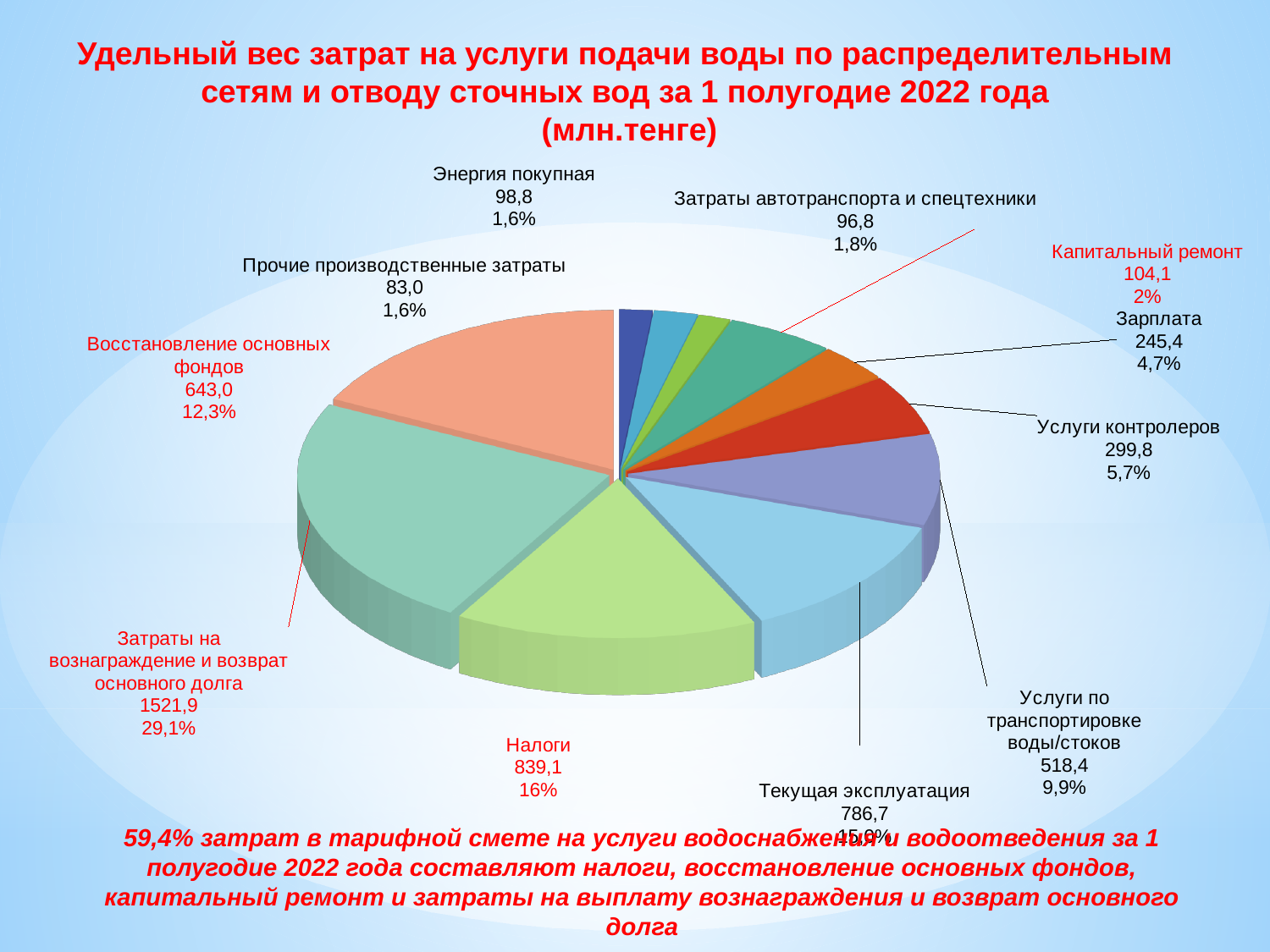
What is the value for Услуги контролеров? 299,8 What is the value for Налоги? 839,1 What share of the pie does Услуги по транспортировке воды/стоков represent? 9,9% Which category has the largest value? Затраты на вознаграждение и возврат основного долга What share of the pie does Затраты на вознаграждение и возврат основного долга represent? 29,1% What is the difference between the values for Услуги контролеров and Зарплата? 54,4 How many categories (slices) does the pie chart show? 11 Which category has the smallest value? Прочие производственные затраты What is the difference between the values for Налоги and Текущая эксплуатация? 52,4 What is the value for Восстановление основных фондов? 643,0 Which is larger, the value for Восстановление основных фондов or the value for Услуги по транспортировке воды/стоков? Восстановление основных фондов What kind of chart is shown on the slide? pie chart